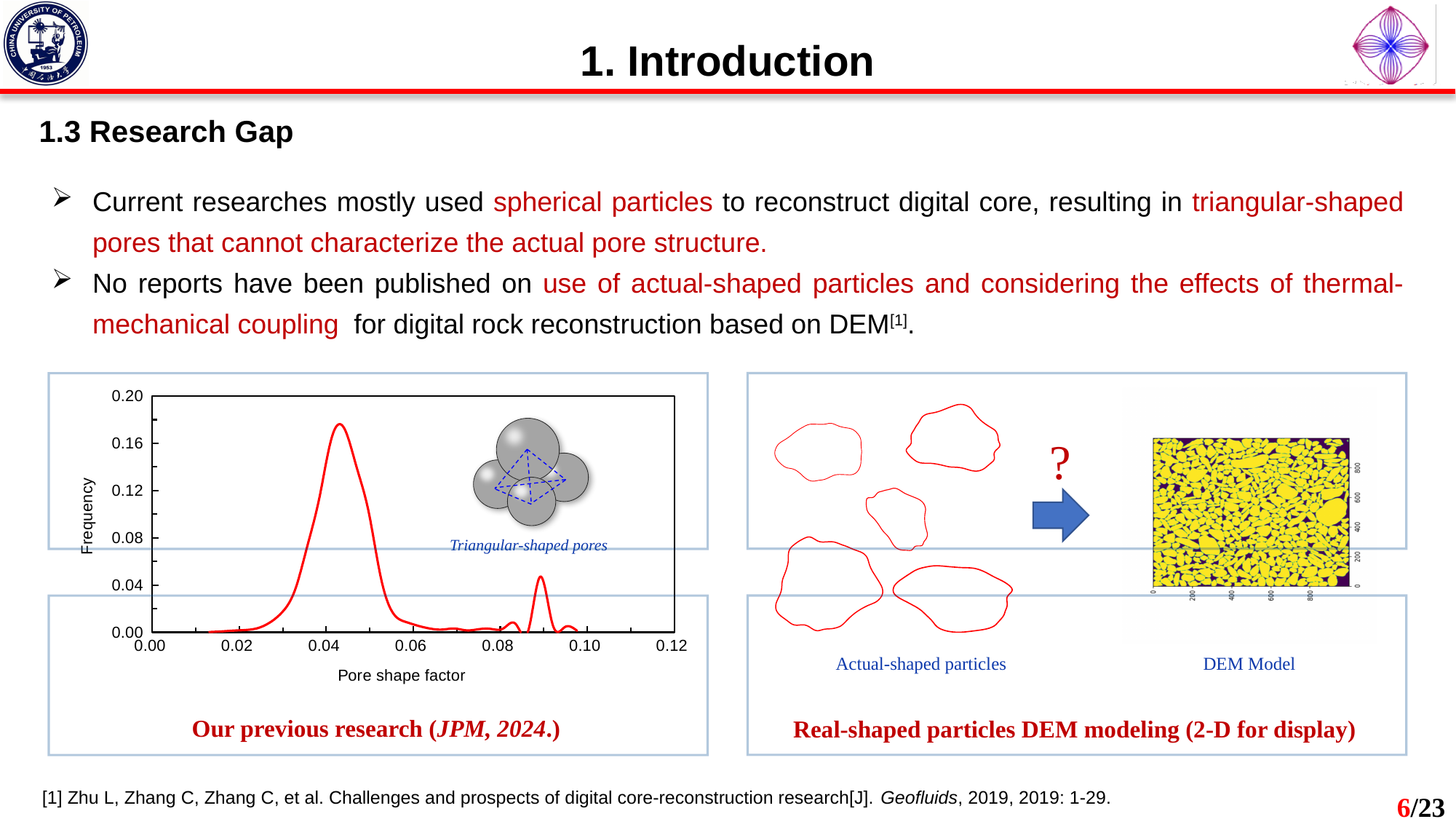
What is the label of the y axis of the chart? Frequency Is the peak frequency of the curve greater or less than 0.16? greater Which is larger: the frequency at a pore shape factor of 0.04 or at 0.08? 0.04 Is the frequency at a pore shape factor of 0.06 greater or less than 0.04? less Which labelled x-axis tick is the main peak of the curve closest to? 0.04 Does the frequency rise or fall as the pore shape factor increases from 0.04 to 0.06? fall What kind of chart is shown on the left of the slide? line chart Is the frequency at a pore shape factor of 0.02 greater or less than 0.04? less Does the frequency rise or fall as the pore shape factor increases from 0.02 to 0.04? rise What is the label of the x axis of the chart? Pore shape factor How many lines (series) are plotted in the chart? 1